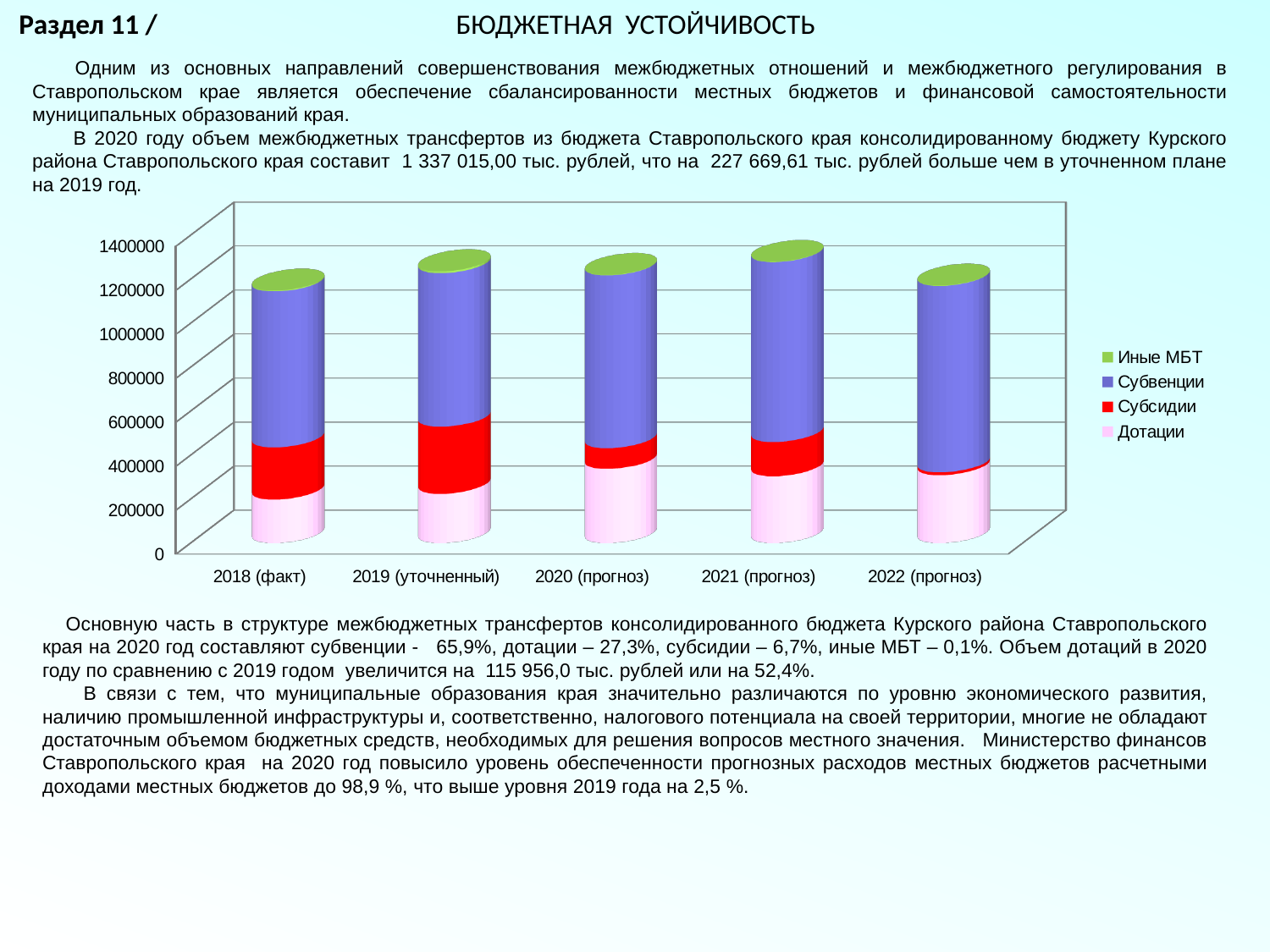
Is the Дотации segment for 2018 (факт) greater or less than 400000? less How many series does the chart legend list? 4 What kind of chart is shown on the slide? Stacked bar chart Which series appears at the top of each stacked bar, shown in green? Иные МБТ What is the label of the first category on the x axis? 2018 (факт) Is the total value for 2019 (уточненный) greater or less than 1000000? greater Is the total value for 2021 (прогноз) greater or less than 1200000? greater Which year has the highest total bar in the chart? 2021 (прогноз) Which series is shown in red in the chart? Субсидии In the 2020 (прогноз) bar, which segment is larger: Субвенции or Дотации? Субвенции In the 2022 (прогноз) bar, which segment is larger: Дотации or Субсидии? Дотации How many categories (years) are shown on the x axis of the chart? 5